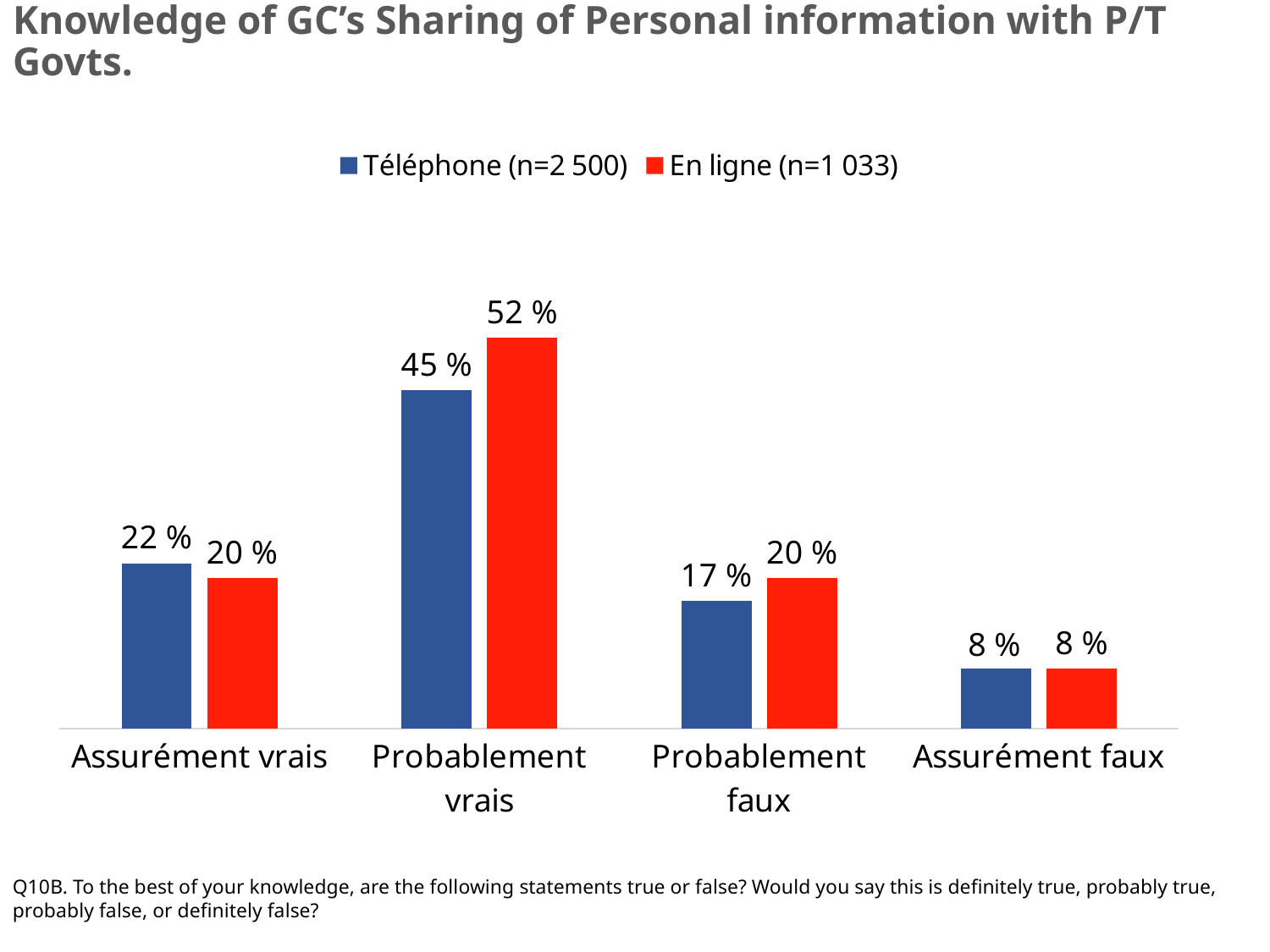
How many series does the legend list? 2 What is the value for En ligne (n=1 033) in the Assurément vrais category? 20 % In the Assurément vrais category, which series has the larger value, Téléphone (n=2 500) or En ligne (n=1 033)? Téléphone (n=2 500) What is the value for Téléphone (n=2 500) in the Probablement vrais category? 45 % Which category has the lowest value for Téléphone (n=2 500)? Assurément faux Which category has the highest value for En ligne (n=1 033)? Probablement vrais What kind of chart is shown on the slide? Bar chart What is the difference between the En ligne (n=1 033) and Téléphone (n=2 500) values in the Probablement vrais category? 7 % How many categories are shown on the x axis? 4 What colour are the bars for the En ligne (n=1 033) series? Red What is the value for Téléphone (n=2 500) in the Probablement faux category? 17 % What is the value for En ligne (n=1 033) in the Assurément faux category? 8 %